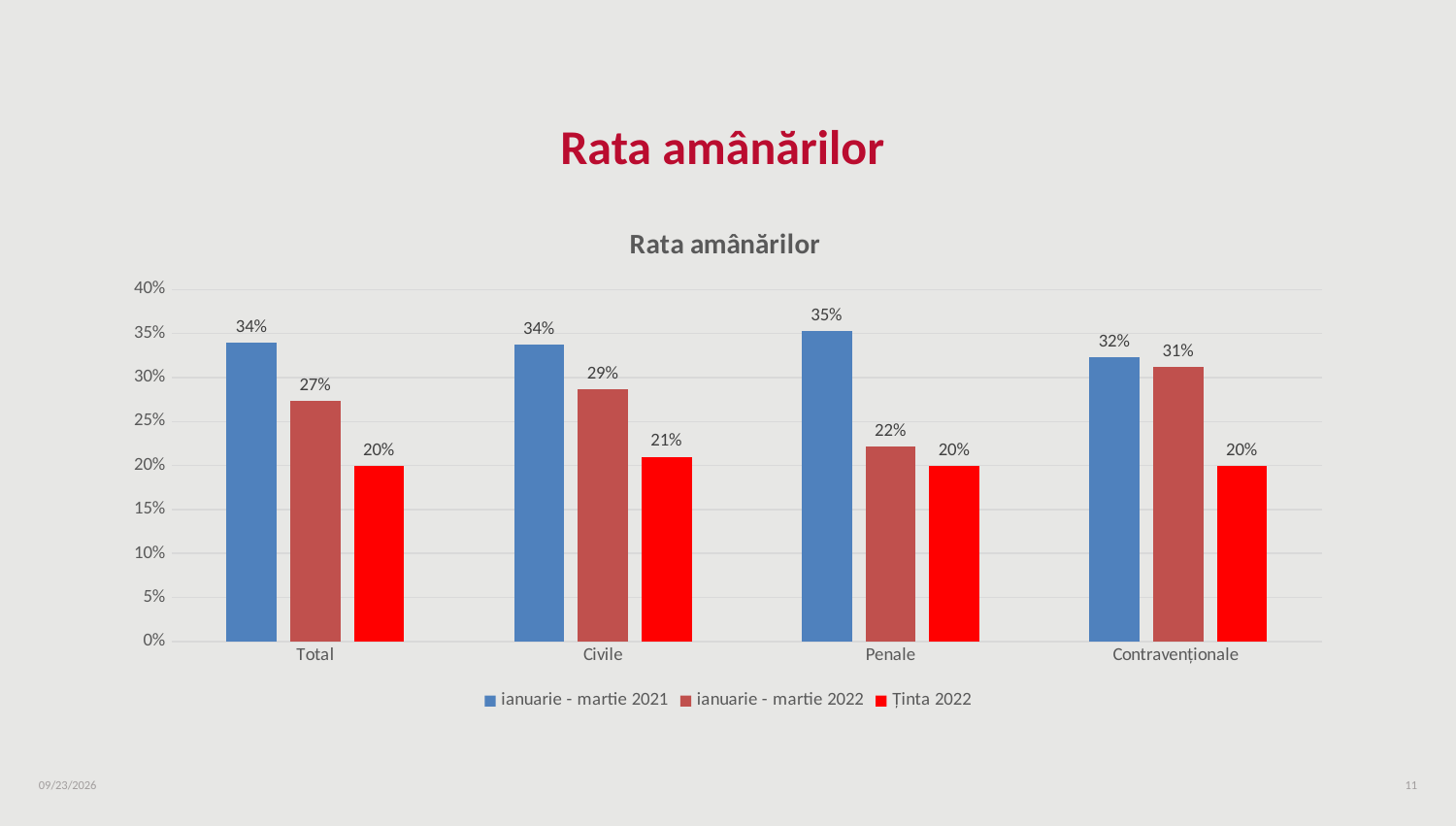
What is the value for Penale in the ianuarie - martie 2021 series? 35% What kind of chart is shown on the slide? bar chart What is the Ținta 2022 value for Civile? 21% Which category has the highest value in the ianuarie - martie 2022 series? Contravenționale What is the value for Civile in the ianuarie - martie 2022 series? 29% What is the difference between the ianuarie - martie 2021 and ianuarie - martie 2022 values for Penale? 13% What is the title of the chart? Rata amânărilor Is the ianuarie - martie 2022 value for Contravenționale greater or less than 25%? greater Which is larger for Total: the ianuarie - martie 2021 value or the ianuarie - martie 2022 value? ianuarie - martie 2021 Which category has the lowest value in the ianuarie - martie 2022 series? Penale How many series does the legend list? 3 How many categories are shown on the x axis? 4